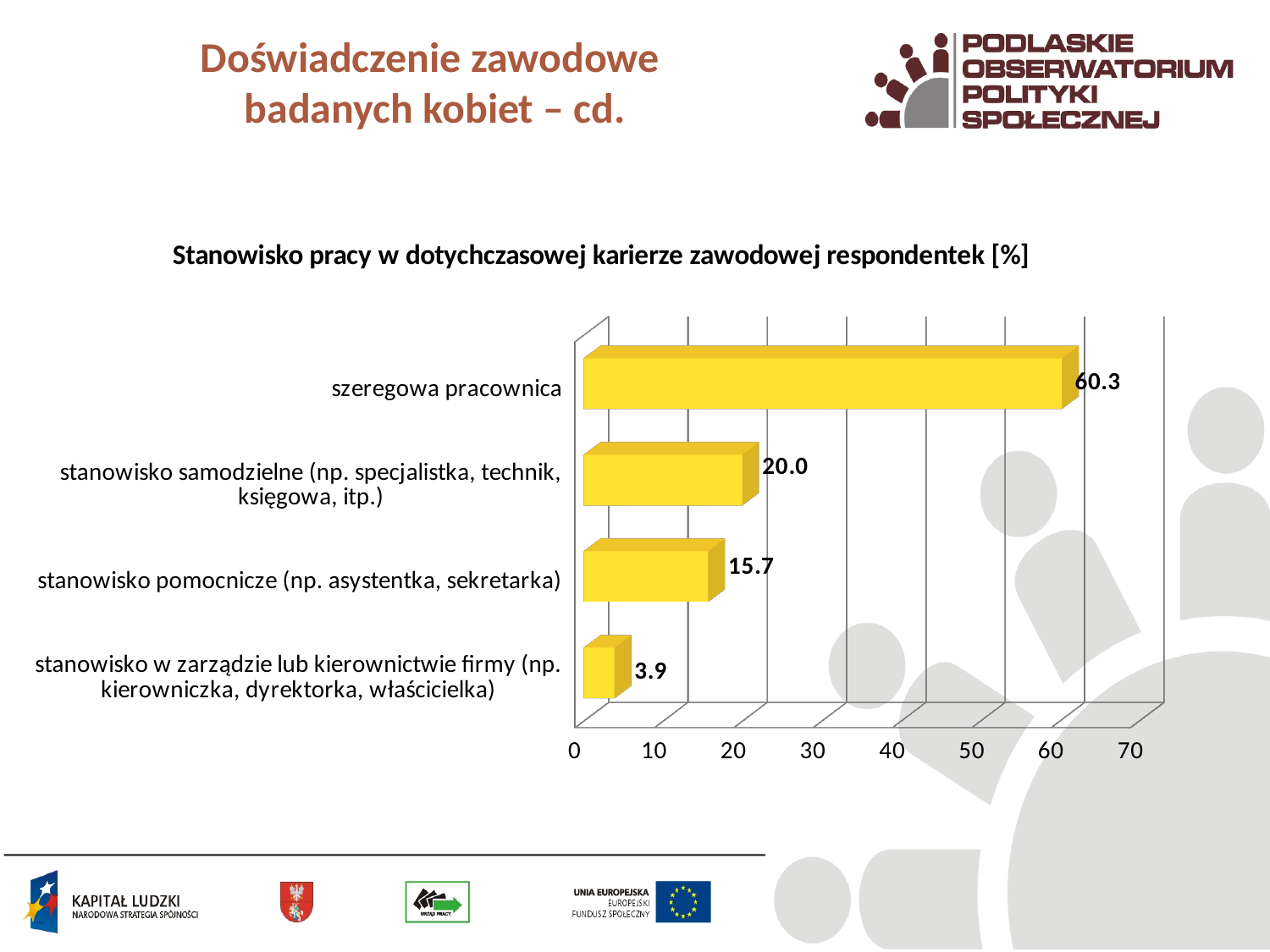
What is the difference between the values for "stanowisko samodzielne" and "stanowisko pomocnicze"? 4.3 What kind of chart is shown on the slide? bar chart What is the value for "szeregowa pracownica"? 60.3 What is the title of the chart? Stanowisko pracy w dotychczasowej karierze zawodowej respondentek [%] Which is larger: the value for "stanowisko pomocnicze" or for "stanowisko w zarządzie lub kierownictwie firmy"? stanowisko pomocnicze What is the value for "stanowisko pomocnicze (np. asystentka, sekretarka)"? 15.7 What is the value for "stanowisko w zarządzie lub kierownictwie firmy (np. kierowniczka, dyrektorka, właścicielka)"? 3.9 Which category has the lowest value? stanowisko w zarządzie lub kierownictwie firmy (np. kierowniczka, dyrektorka, właścicielka) Which category has the highest value? szeregowa pracownica How many categories are shown in the chart? 4 What is the value for "stanowisko samodzielne (np. specjalistka, technik, księgowa, itp.)"? 20.0 What is the difference between the values for "szeregowa pracownica" and "stanowisko samodzielne"? 40.3